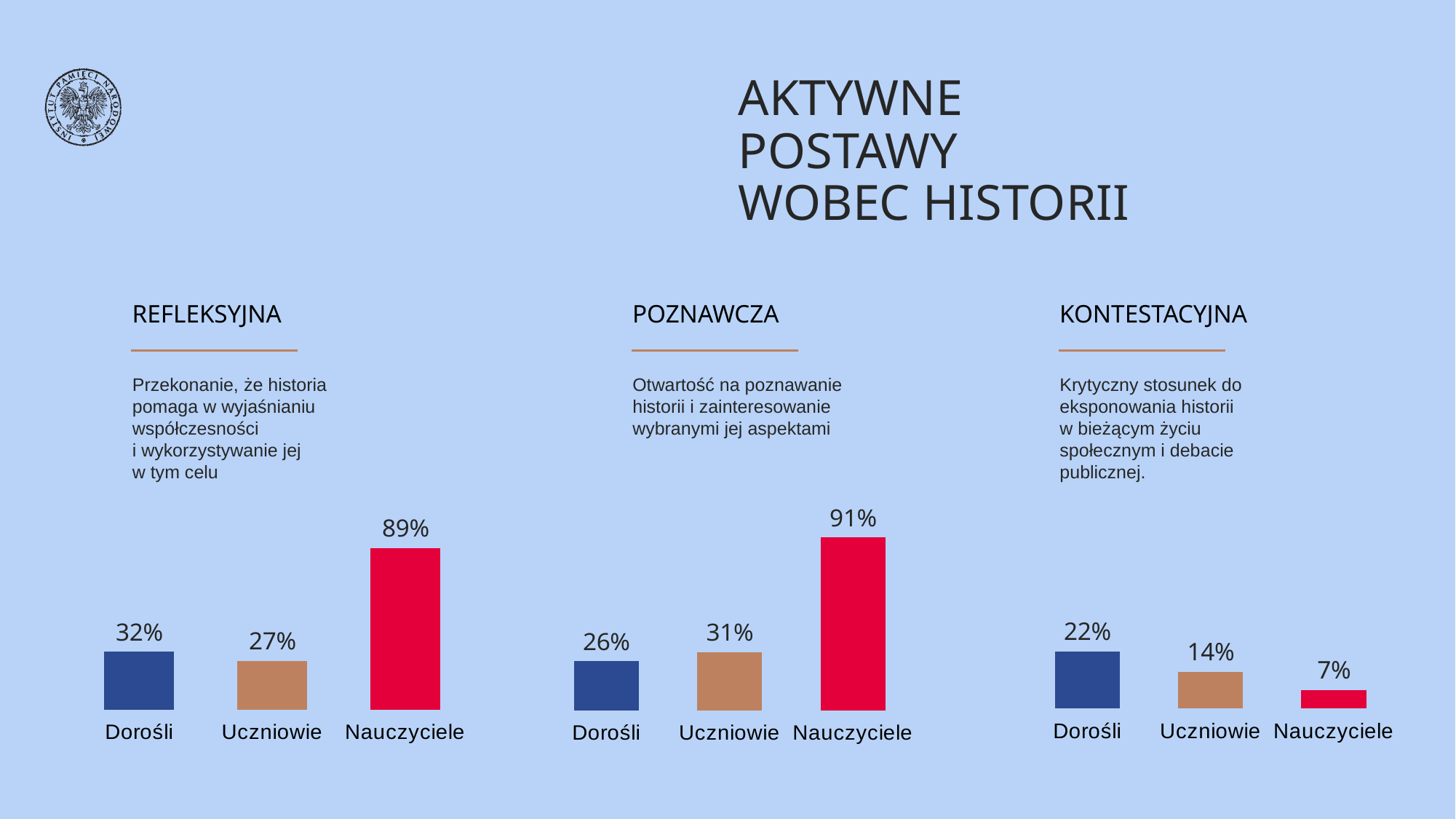
In the KONTESTACYJNA chart, what is the value for Nauczyciele? 7% In the KONTESTACYJNA chart, what is the difference between the values for Dorośli and Uczniowie? 8% In the POZNAWCZA chart, what is the value for Dorośli? 26% In the KONTESTACYJNA chart, do the values rise or fall from Dorośli to Nauczyciele? Fall In the POZNAWCZA chart, which is larger, the value for Dorośli or the value for Uczniowie? Uczniowie In the KONTESTACYJNA chart, which category has the lowest value? Nauczyciele In the REFLEKSYJNA chart, what is the difference between the values for Nauczyciele and Dorośli? 57% In the POZNAWCZA chart, which category has the highest value? Nauczyciele In the REFLEKSYJNA chart, what is the value for Uczniowie? 27% In the REFLEKSYJNA chart, what is the value for Nauczyciele? 89% What kind of chart is the POZNAWCZA chart? Bar chart How many categories does the KONTESTACYJNA chart show? 3